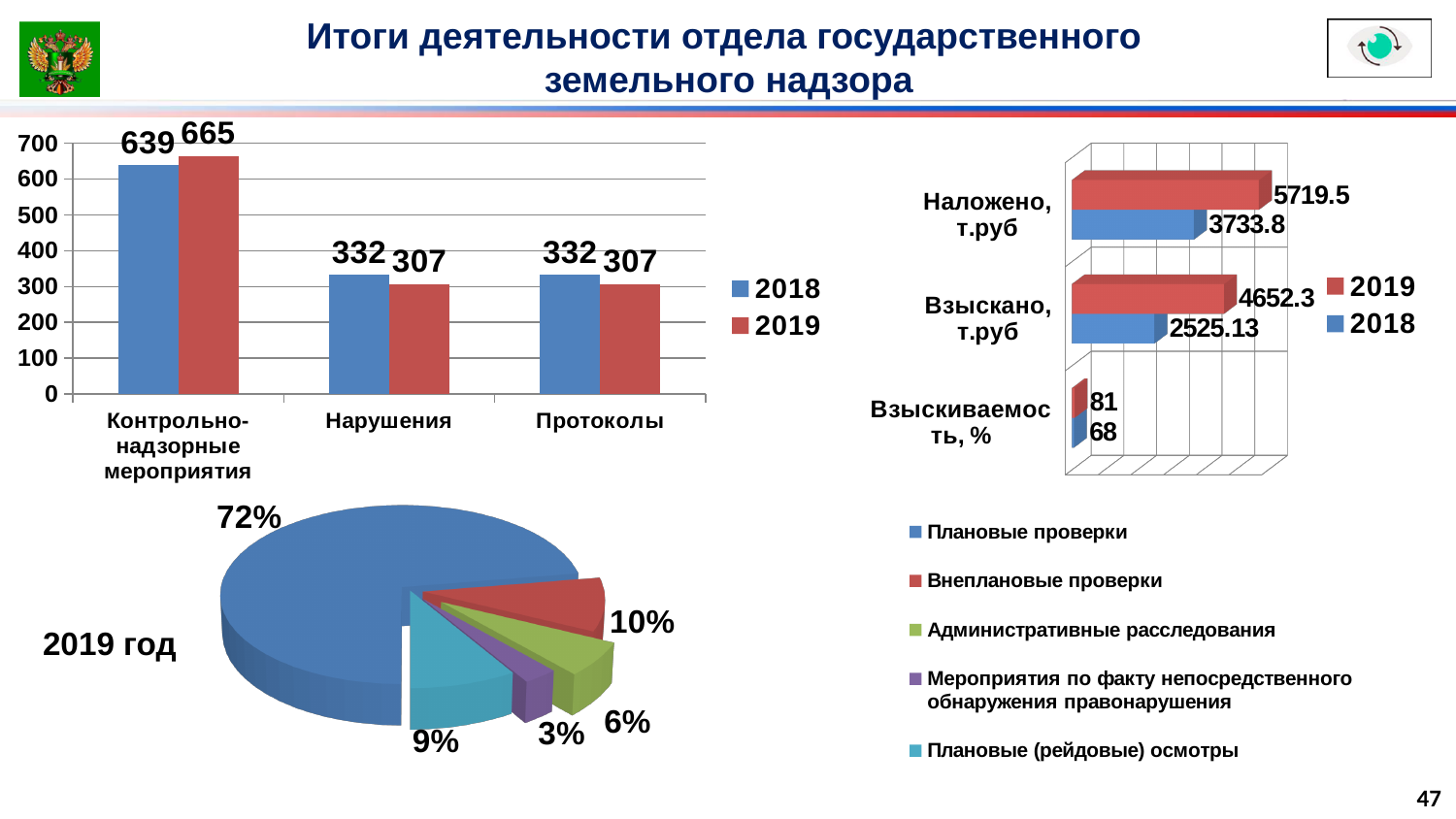
In the top-right chart, what is the difference between the 2019 and 2018 values for Взыскиваемость, %? 13 In the top-left bar chart, what is the 2019 value for Контрольно-надзорные мероприятия? 665 In the top-left bar chart, how many series does the legend list? 2 In the pie chart for 2019 год, how many slices are there? 5 In the pie chart for 2019 год, what share does the largest slice (Плановые проверки) have? 72% In the top-left bar chart, is the 2019 value for Протоколы larger or smaller than the 2018 value? smaller In the top-right chart, what is the 2019 value for Наложено, т.руб? 5719.5 In the top-right chart, what is the 2018 value for Взыскано, т.руб? 2525.13 What kind of chart is the top-right chart? bar chart In the top-left bar chart, which category has the highest 2018 value? Контрольно-надзорные мероприятия In the top-left bar chart, what is the difference between the 2019 and 2018 values for Контрольно-надзорные мероприятия? 26 In the top-left bar chart, what is the 2018 value for Нарушения? 332